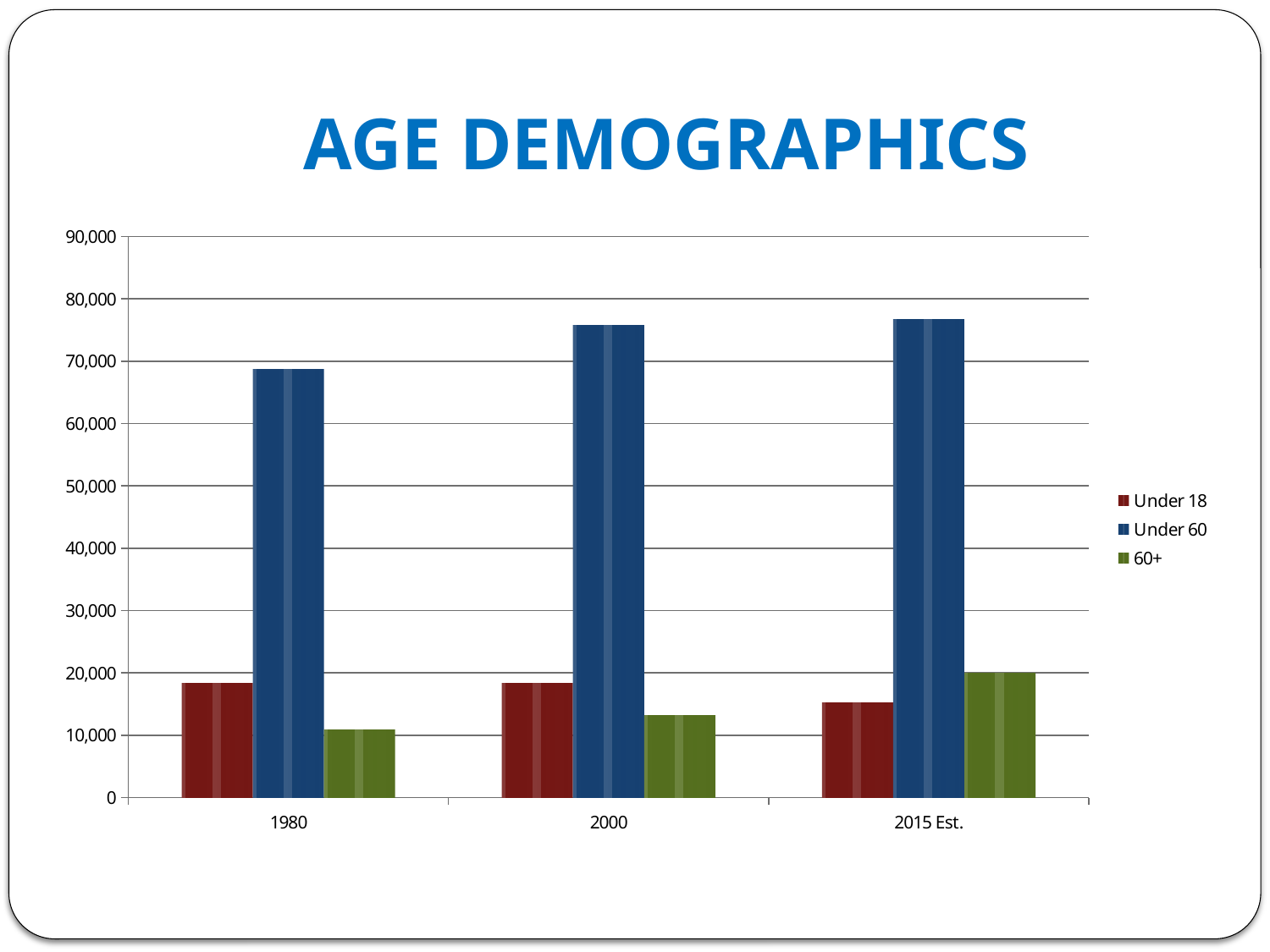
In which year is the 60+ value the lowest? 1980 In which year is the Under 18 value the lowest? 2015 Est. Is the Under 18 value for 1980 greater or less than 20,000? less Is the Under 60 value for 2000 greater or less than 70,000? greater What kind of chart is shown on the slide? Bar chart How many year categories are shown on the x axis? 3 How many series does the legend list? 3 In which year is the 60+ value the highest? 2015 Est. Does the 60+ value rise or fall from 1980 to 2015 Est.? Rises Which is larger in 2000, the Under 60 value or the 60+ value? Under 60 What is the title of the slide? AGE DEMOGRAPHICS Is the Under 60 value for 1980 greater or less than 70,000? less